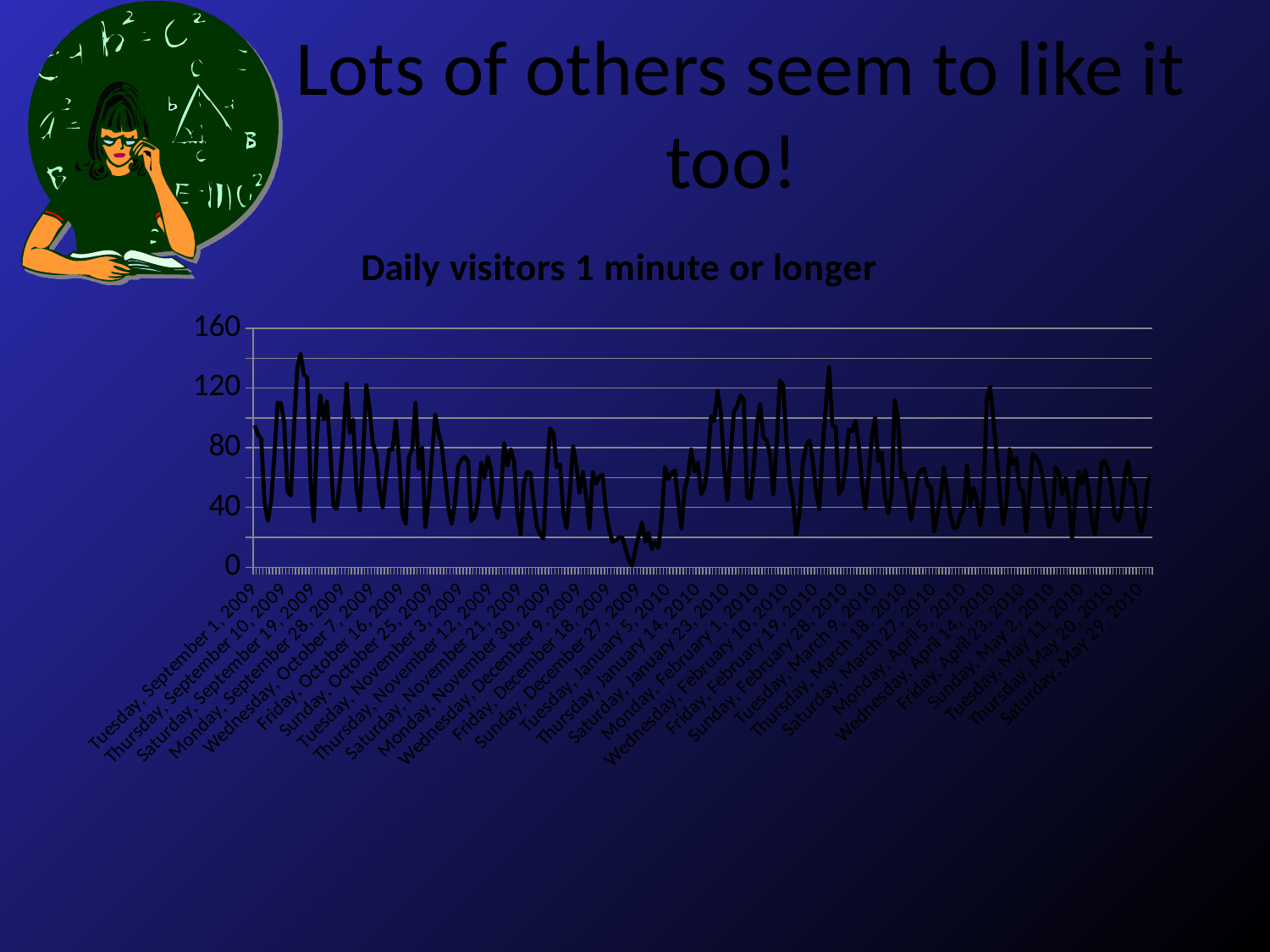
What kind of chart is shown on the slide? line chart How many lines (data series) are plotted on the chart? 1 Do the daily visitor values generally rise or fall between early September 2009 and late December 2009? fall What is the last date label on the horizontal axis of the chart? Saturday, May 29, 2010 In which month does the line reach its lowest point? December 2009 Is the highest peak of the line greater or less than 120? greater Do the daily visitor values generally rise or fall between late December 2009 and February 2010? rise Is the highest peak of the line greater or less than 160? less Is the lowest point of the line, in late December 2009, greater or less than 40? less What is the highest value shown on the vertical axis of the chart? 160 What is the first date label on the horizontal axis of the chart? Tuesday, September 1, 2009 What is the title of the chart? Daily visitors 1 minute or longer